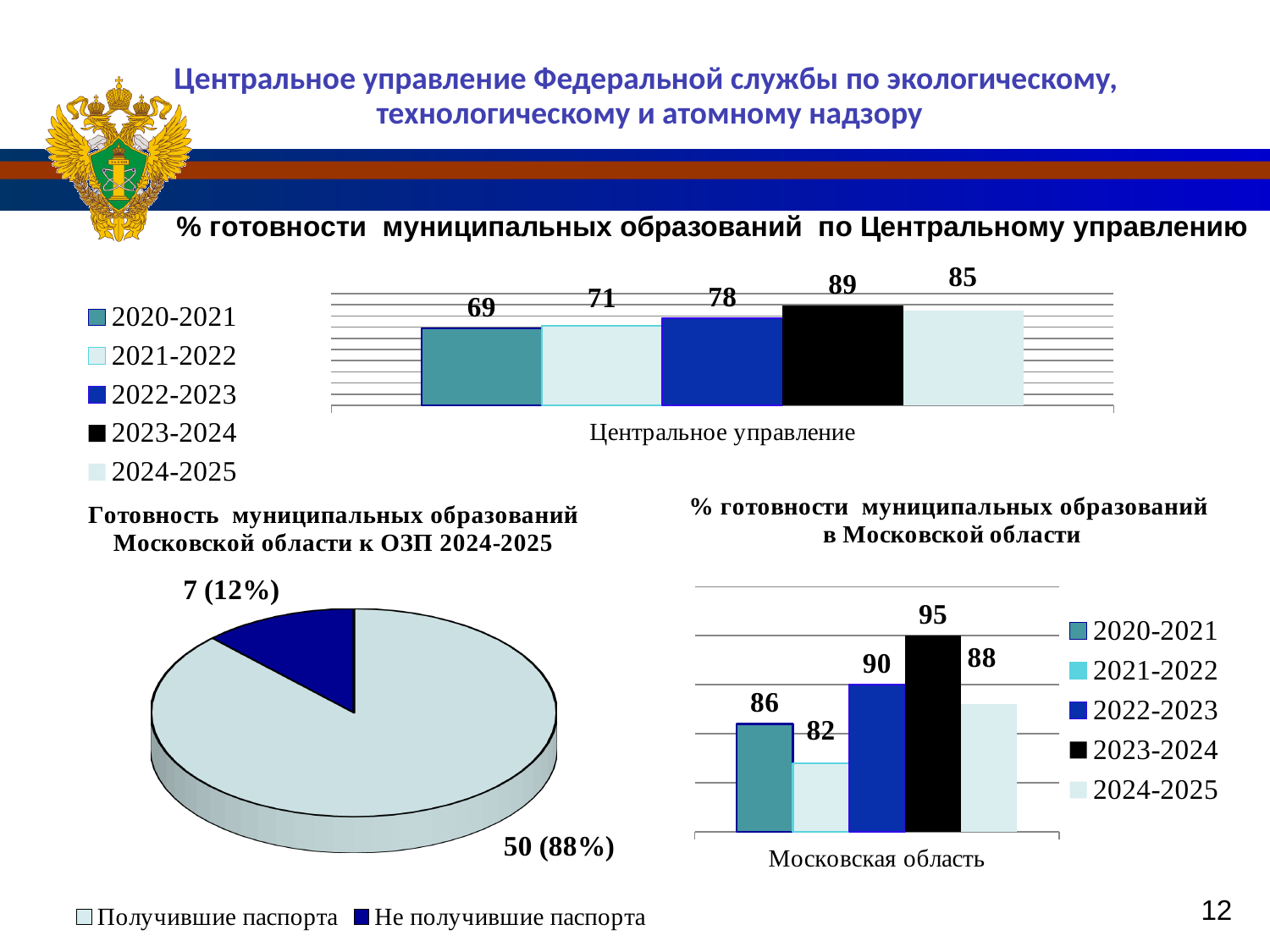
In the top chart '% готовности муниципальных образований по Центральному управлению', what is the category label on the x axis? Центральное управление In the top chart '% готовности муниципальных образований по Центральному управлению', what is the difference between the 2023-2024 and 2024-2025 values? 4 In the bottom-left pie chart 'Готовность муниципальных образований Московской области к ОЗП 2024-2025', what is the value for 'Получившие паспорта'? 50 (88%) What kind of chart is the bottom-left chart 'Готовность муниципальных образований Московской области к ОЗП 2024-2025'? Pie chart In the top chart '% готовности муниципальных образований по Центральному управлению', what is the value for 2020-2021? 69 In the bottom-left pie chart 'Готовность муниципальных образований Московской области к ОЗП 2024-2025', what share of the pie is 'Не получившие паспорта'? 12% In the bottom-right chart '% готовности муниципальных образований в Московской области', what is the difference between the 2023-2024 and 2020-2021 values? 9 In the bottom-right chart '% готовности муниципальных образований в Московской области', which is larger: the value for 2022-2023 or the value for 2024-2025? 2022-2023 In the top chart '% готовности муниципальных образований по Центральному управлению', which series has the highest value? 2023-2024 In the bottom-right chart '% готовности муниципальных образований в Московской области', which series has the lowest value? 2021-2022 In the top chart '% готовности муниципальных образований по Центральному управлению', how many series does the legend list? 5 In the bottom-right chart '% готовности муниципальных образований в Московской области', what is the value for 2021-2022? 82